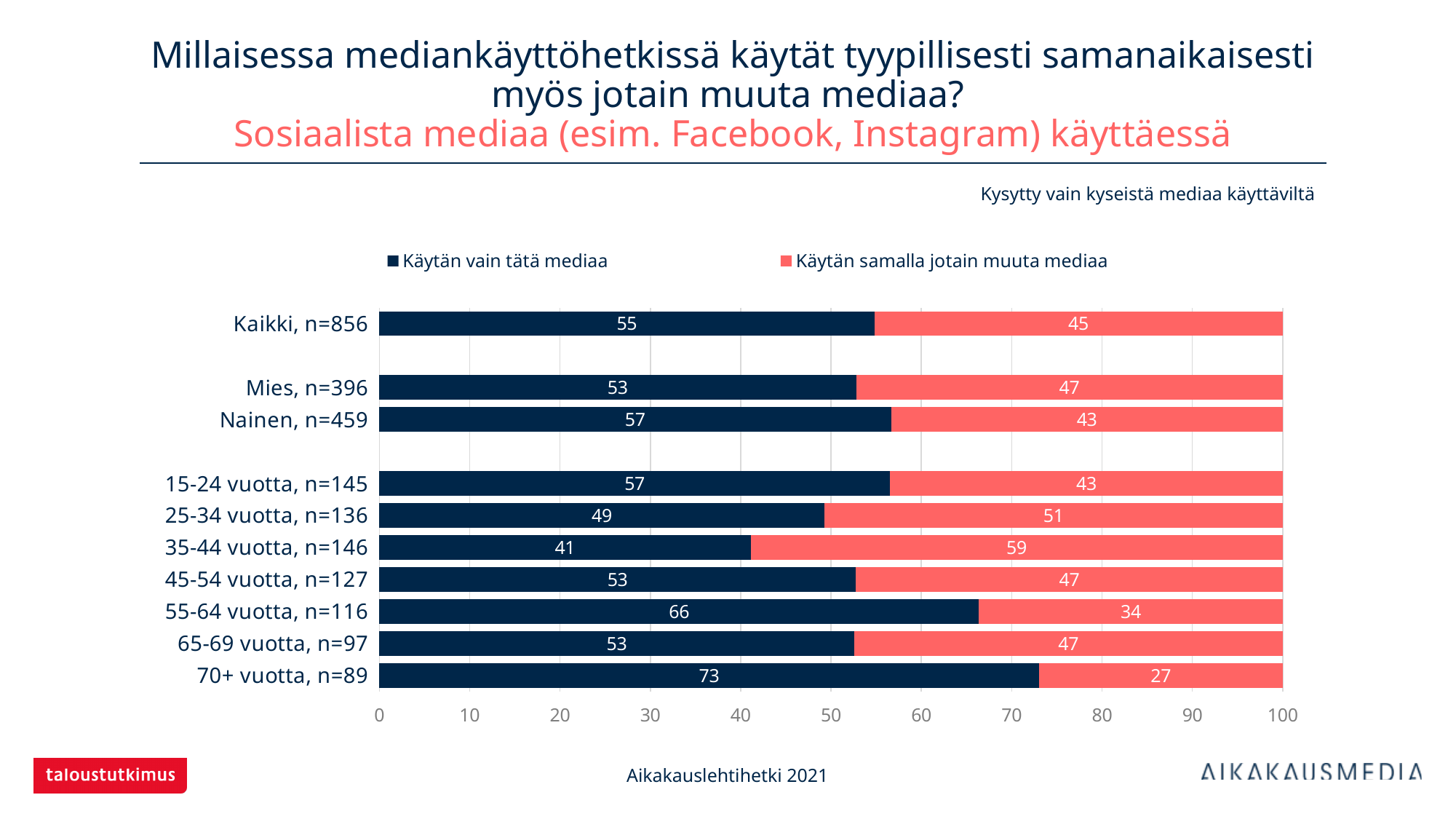
What colour represents the series "Käytän samalla jotain muuta mediaa"? Red (coral) Which category has the highest value for "Käytän vain tätä mediaa"? 70+ vuotta, n=89 What is the value of "Käytän vain tätä mediaa" for 70+ vuotta, n=89? 73 What is the total of the stacked bar for 55-64 vuotta, n=116? 100 What is the value of "Käytän samalla jotain muuta mediaa" for 35-44 vuotta, n=146? 59 Which category has the lowest value for "Käytän vain tätä mediaa"? 35-44 vuotta, n=146 How many series does the legend list? 2 What kind of chart is shown on the slide? Stacked bar chart How many categories are shown on the chart? 10 Which has a larger "Käytän samalla jotain muuta mediaa" value: 25-34 vuotta, n=136 or 55-64 vuotta, n=116? 25-34 vuotta, n=136 What is the value of "Käytän vain tätä mediaa" for Kaikki, n=856? 55 What is the difference between the "Käytän vain tätä mediaa" values for Nainen, n=459 and Mies, n=396? 4